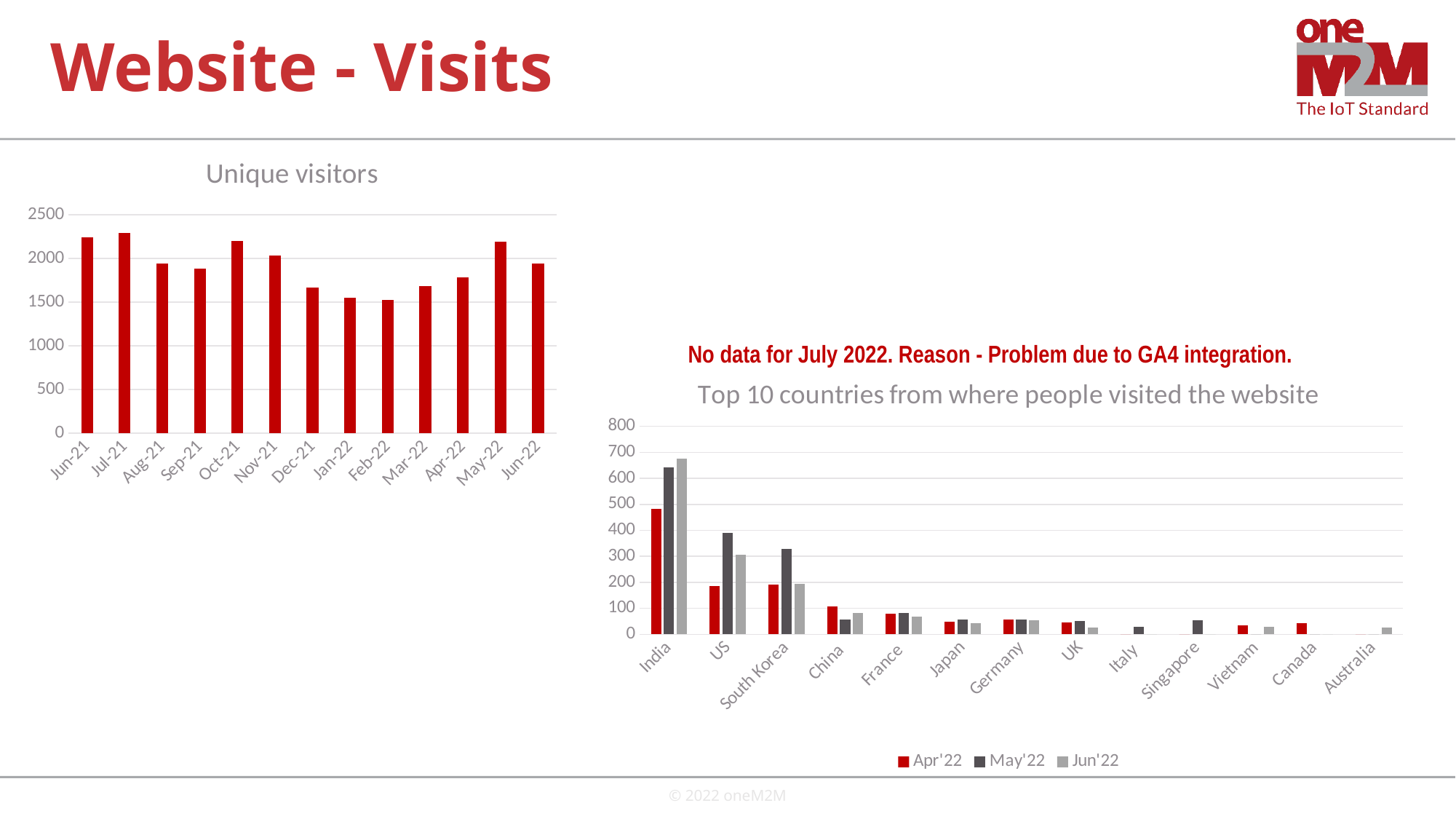
On the Unique visitors chart, how many months are shown on the x axis? 13 On the Top 10 countries chart, is the Apr'22 value for US greater or less than 200? less On the Top 10 countries chart, which is larger, the May'22 value for US or the May'22 value for South Korea? US On the Top 10 countries chart, which country has the highest value for Jun'22? India On the Top 10 countries chart, how many series does the legend list? 3 On the Unique visitors chart, is the value for Jun-21 greater or less than 2000? greater On the Unique visitors chart, do the values rise or fall from Jul-21 to Feb-22? fall On the Top 10 countries chart, is the Jun'22 value for India greater or less than 600? greater On the Unique visitors chart, which is larger, the value for Oct-21 or the value for Dec-21? Oct-21 On the Top 10 countries chart, what are the legend entries? Apr'22, May'22, Jun'22 What kind of chart is the Unique visitors chart? bar chart